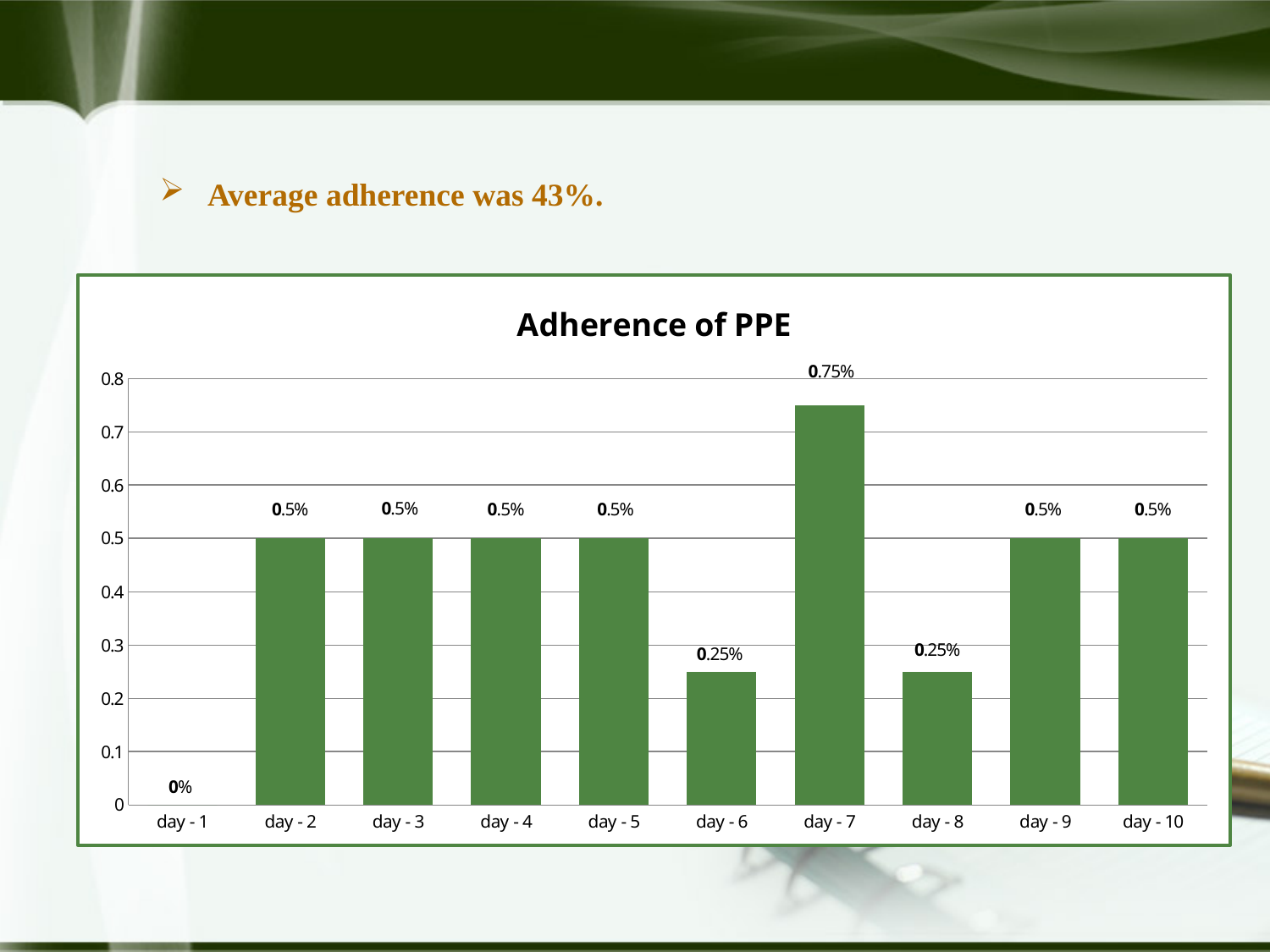
What is the data label shown for day - 1? 0% What is the data label shown for day - 2? 0.5% What is the data label shown for day - 6? 0.25% What is the title of the chart? Adherence of PPE Is the bar for day - 7 greater or less than 0.7 on the y axis? greater Is the bar for day - 8 greater or less than 0.3 on the y axis? less How many days are shown on the x axis of the chart? 10 Which is larger, the value for day - 7 or the value for day - 8? day - 7 What is the data label shown for day - 7? 0.75% Which day has the lowest value in the chart? day - 1 Which day has the highest bar in the chart? day - 7 What kind of chart is shown on the slide? bar chart